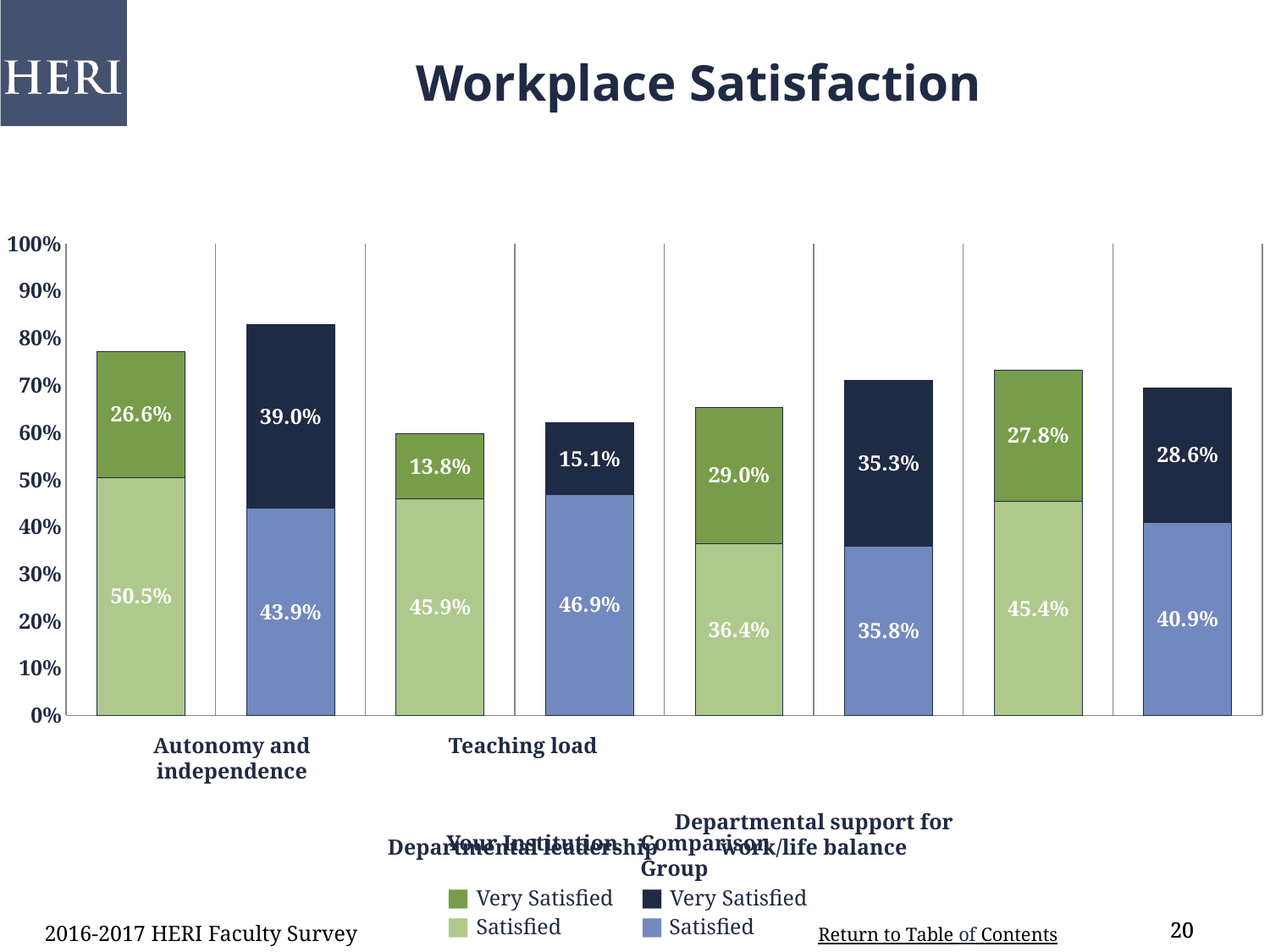
How many series does the legend list? 4 What percentage of Your Institution faculty are Satisfied with Autonomy and independence? 50.5% What type of chart is shown on the slide? stacked bar chart What percentage of Your Institution faculty are Very Satisfied with Teaching load? 13.8% Which is larger: the Your Institution Satisfied value for Teaching load or the Comparison Group Satisfied value for Teaching load? Comparison Group (46.9%) How many categories are shown on the x axis? 4 What is the difference between the Comparison Group and Your Institution Very Satisfied values for Autonomy and independence? 12.4% What percentage of the Comparison Group is Very Satisfied with Autonomy and independence? 39.0% What percentage of the Comparison Group is Satisfied with Teaching load? 46.9% What is the total of the Comparison Group stacked bar for Teaching load? 62.0% What percentage of the Comparison Group is Very Satisfied with Departmental support for work/life balance? 28.6% What is the total of the Your Institution stacked bar for Autonomy and independence? 77.1%